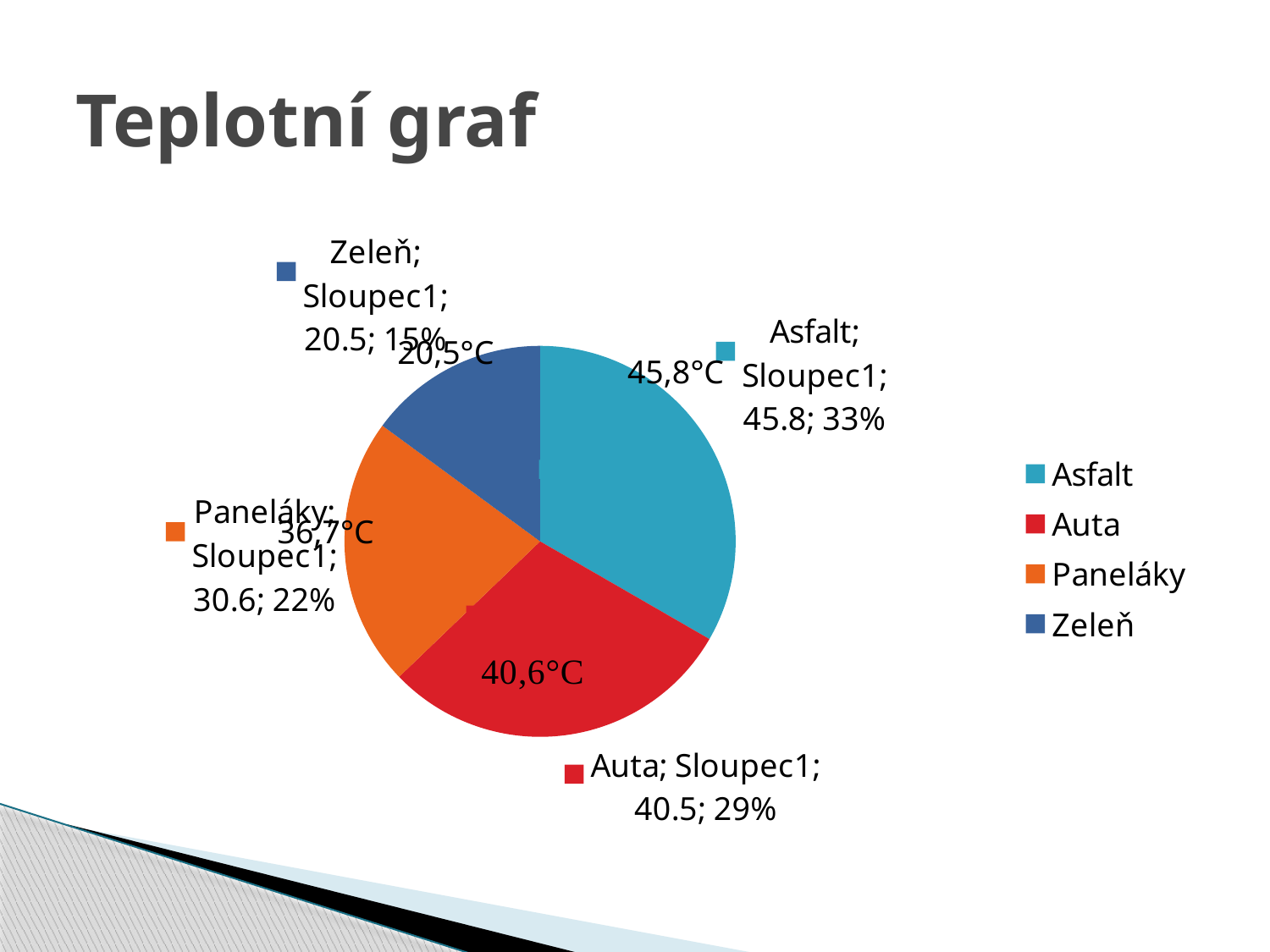
What value is shown in the data label for Asfalt? 45.8 What value is shown in the data label for Paneláky? 30.6 How many entries does the legend list? 4 What percentage share of the pie does Paneláky have? 22% What value is shown in the data label for Auta? 40.5 Which category has the largest slice of the pie? Asfalt What is the title of the slide containing the chart? Teplotní graf What type of chart is shown on the slide? pie chart How many slices does the pie chart have? 4 What value is shown in the data label for Zeleň? 20.5 What is the difference between the data label values for Asfalt and Zeleň? 25.3 Which category has the smallest slice of the pie? Zeleň